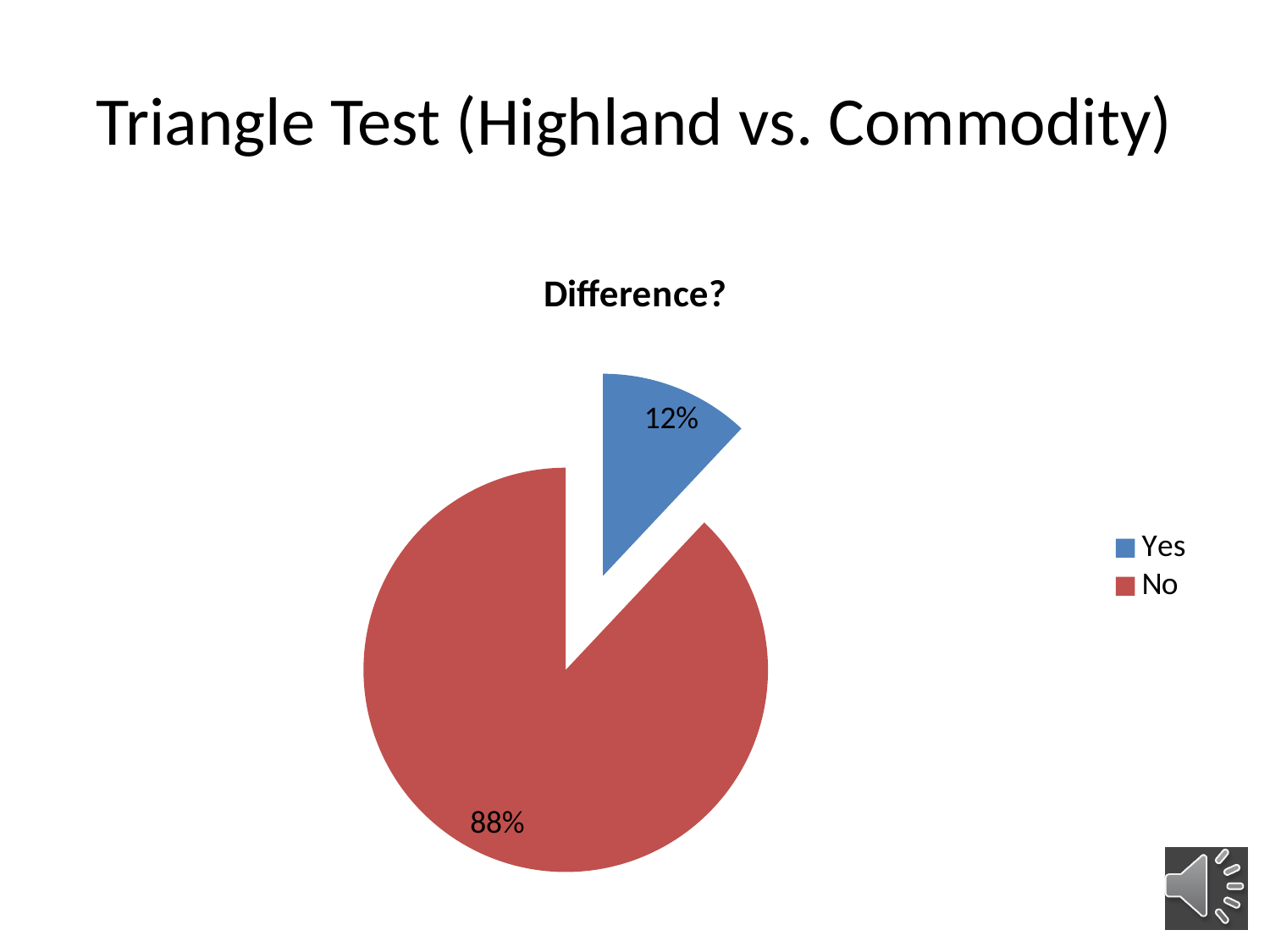
Which slice is larger, "Yes" or "No"? No What is the title of the chart? Difference? How many categories are shown in the pie chart? 2 What kind of chart is shown on the slide? Pie chart What is the difference in percentage points between the "No" and "Yes" slices? 76 Which category has the smallest slice of the pie? Yes Which category has the largest slice of the pie? No What colour is the "Yes" slice? Blue What share of the pie does the "Yes" slice represent? 12% What share of the pie does the "No" slice represent? 88%